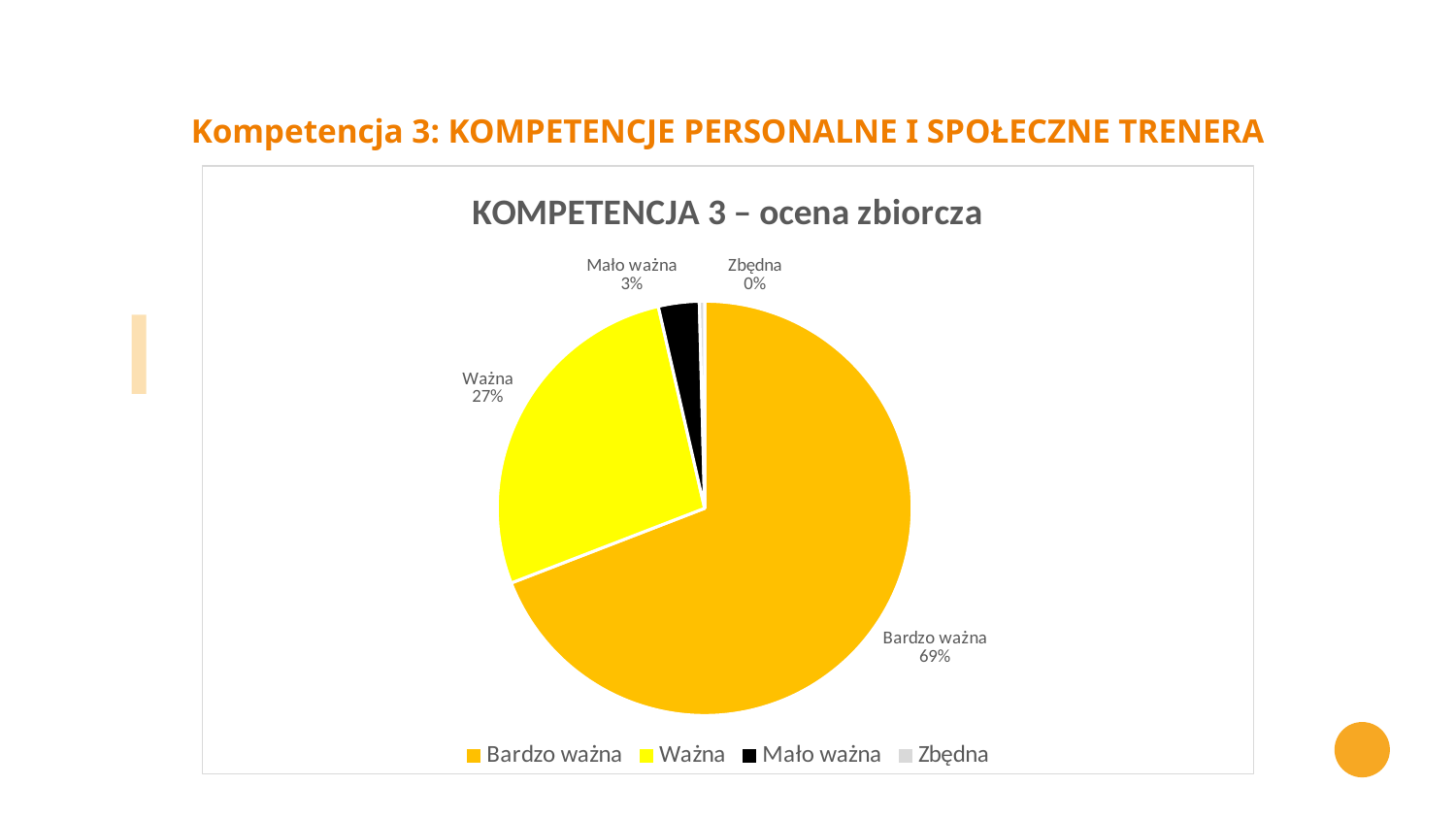
Which category has the smallest slice of the pie? Zbędna What is the value shown for "Zbędna"? 0% What share of the pie does "Bardzo ważna" represent? 69% What is the difference in percentage points between "Bardzo ważna" and "Ważna"? 42 How many categories are shown in the pie chart? 4 What kind of chart is shown on the slide? Pie chart Which category has the largest slice of the pie? Bardzo ważna Which is larger, the slice for "Ważna" or the slice for "Mało ważna"? Ważna What colour is the slice for "Mało ważna"? Black What is the title of the chart? KOMPETENCJA 3 – ocena zbiorcza What is the value shown for "Mało ważna"? 3% What is the value shown for "Ważna"? 27%